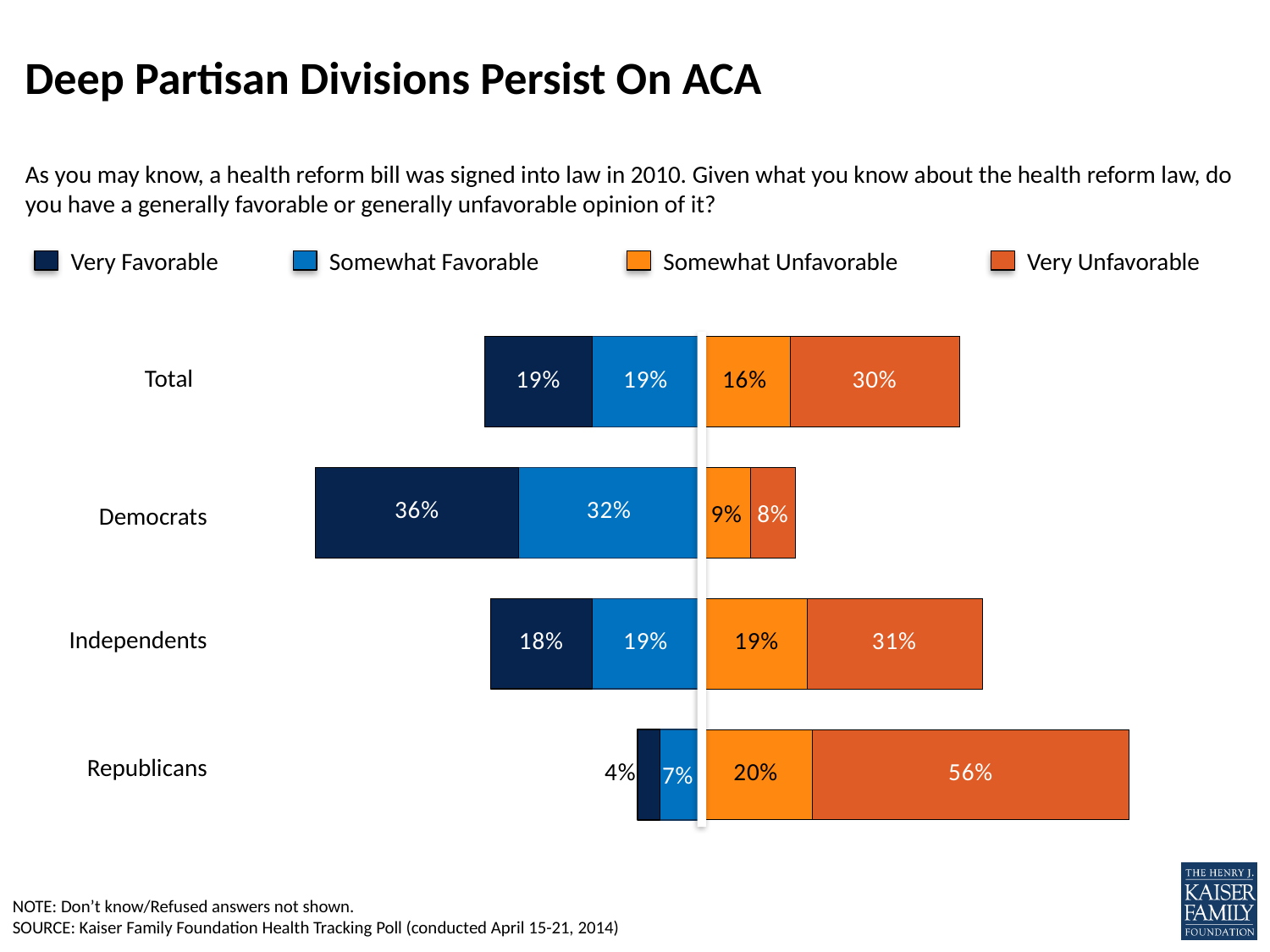
What is the combined Very Favorable and Somewhat Favorable percentage for Democrats? 68% Which group has the lowest Very Favorable percentage? Republicans How many groups are shown on the chart? 4 What percentage of Democrats have a Very Favorable opinion of the health reform law? 36% What is the Somewhat Favorable value for the Total group? 19% Which group has the highest Very Unfavorable percentage? Republicans What kind of chart is shown on the slide? Stacked bar chart What is the Somewhat Unfavorable value for Independents? 19% What is the difference between the Very Unfavorable percentages for Republicans and Democrats? 48 percentage points Which is larger: the Somewhat Favorable value for Democrats or the Somewhat Favorable value for Independents? Democrats How many series does the legend list? 4 What percentage of Republicans have a Very Unfavorable opinion of the health reform law? 56%